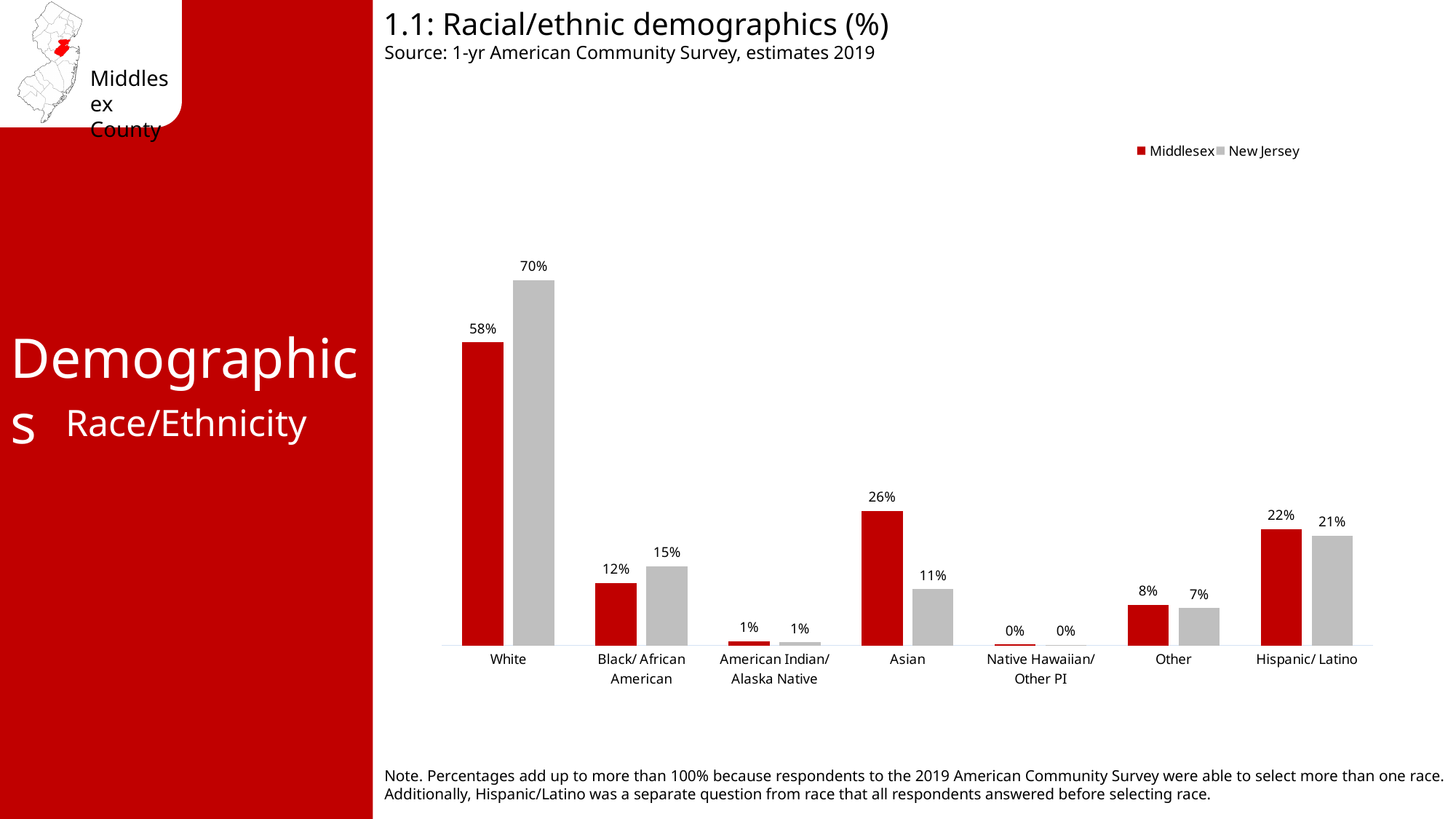
Which category has the lowest New Jersey value? Native Hawaiian/ Other PI How many series does the legend list? 2 Which is larger for Black/ African American, the Middlesex value or the New Jersey value? New Jersey What is the difference between the New Jersey and Middlesex values for White? 12% What is the New Jersey value for Asian? 11% Which category has the highest Middlesex value? White What is the Middlesex value for White? 58% How many categories are shown on the x axis? 7 What is the New Jersey value for Black/ African American? 15% What is the Middlesex value for Hispanic/ Latino? 22% What is the difference between the Middlesex and New Jersey values for Asian? 15% What kind of chart is shown on the slide? Bar chart